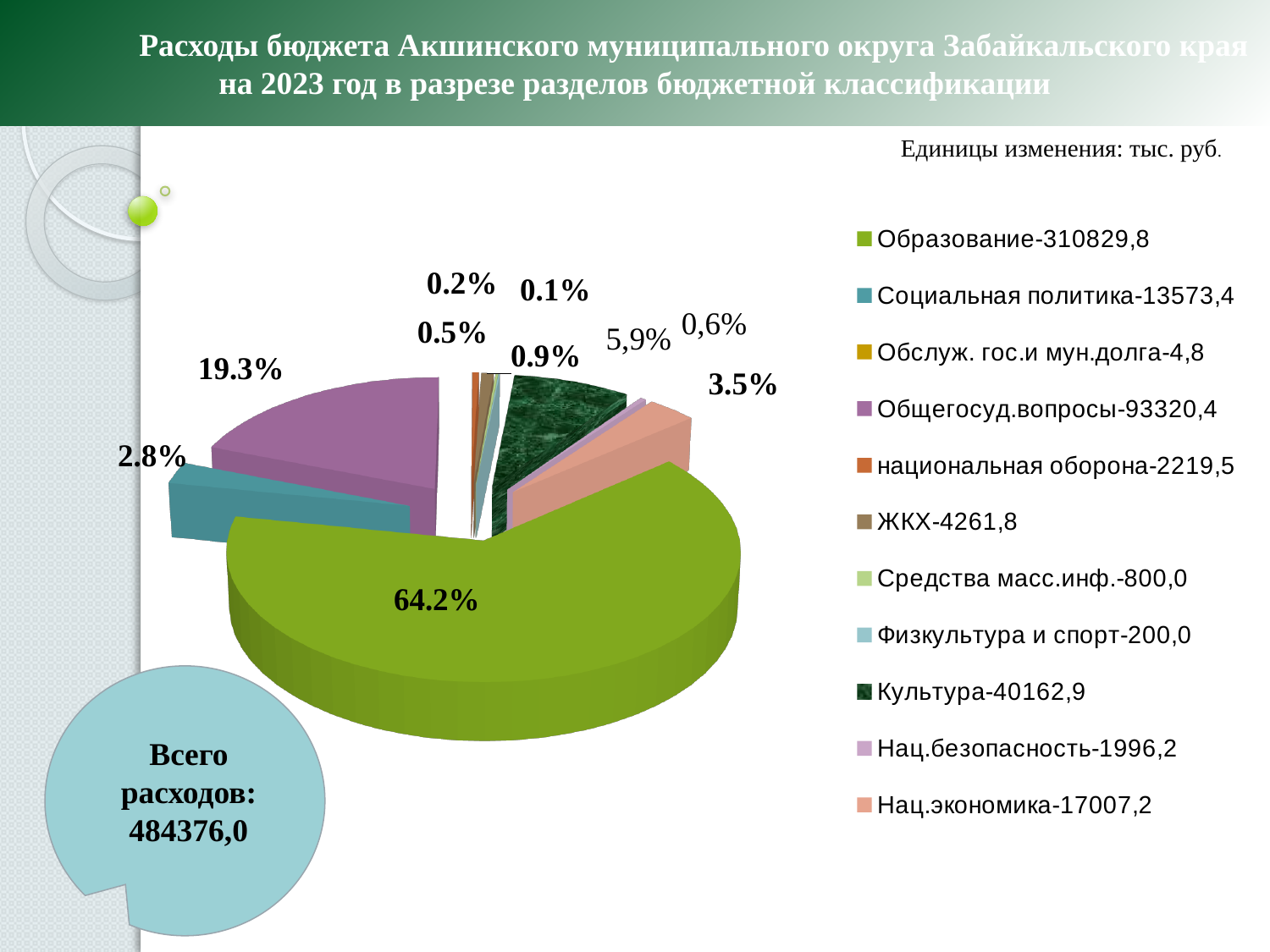
What total expenditure (Всего расходов) is shown on the slide? 484376,0 What is the difference between the values for Образование and Общегосуд.вопросы? 217509,4 What share of the pie does Социальная политика take? 2.8% What value is given for Культура in the legend? 40162,9 Which is larger, the value for Социальная политика or the value for Нац.экономика? Нац.экономика What value is given for Обслуж. гос.и мун.долга in the legend? 4,8 What share of the pie does Образование take? 64.2% What value is given for Нац.экономика in the legend? 17007,2 Which category has the largest share of the pie chart? Образование What share of the pie does Общегосуд.вопросы take? 19.3% How many categories does the legend of the pie chart list? 11 What kind of chart is shown on the slide? pie chart